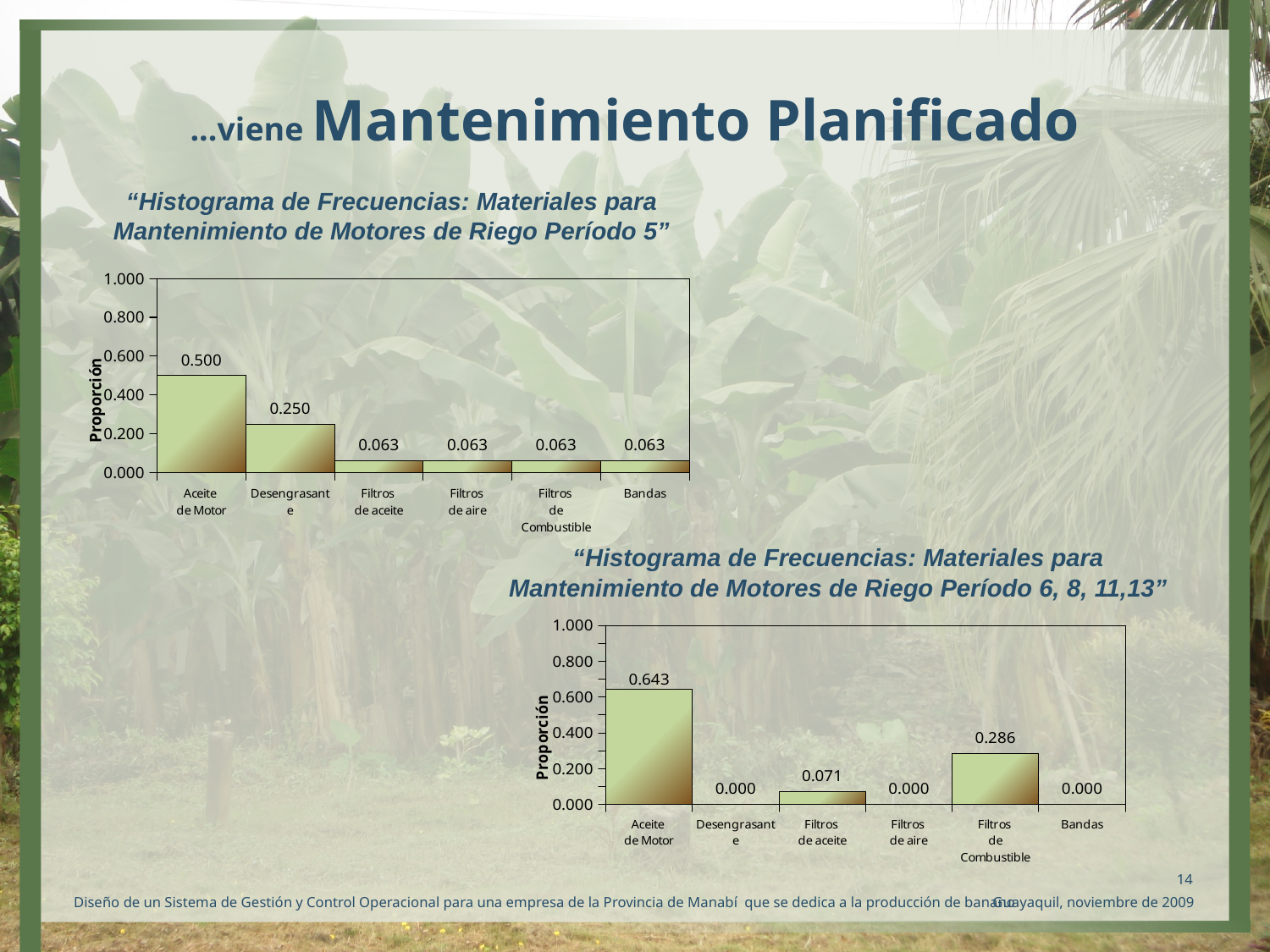
In the bottom chart (Período 6, 8, 11, 13), which category has the highest proportion? Aceite de Motor How many categories are shown on the x axis of the top chart (Período 5)? 6 In the bottom chart (Período 6, 8, 11, 13), which is larger: the proportion for Filtros de Combustible or for Filtros de aceite? Filtros de Combustible In the top chart (Período 5), what is the proportion for Desengrasante? 0.250 In the top chart (Período 5), what is the difference between the proportions for Aceite de Motor and Desengrasante? 0.250 What kind of chart is the top chart (Período 5)? Bar chart In the bottom chart (Período 6, 8, 11, 13), what is the proportion for Filtros de Combustible? 0.286 In the bottom chart (Período 6, 8, 11, 13), what is the proportion for Filtros de aceite? 0.071 In the bottom chart (Período 6, 8, 11, 13), what is the difference between the proportions for Aceite de Motor and Filtros de Combustible? 0.357 In the top chart (Período 5), which category has the highest proportion? Aceite de Motor In the top chart (Período 5), what is the proportion for Aceite de Motor? 0.500 What is the y-axis label of the bottom chart (Período 6, 8, 11, 13)? Proporción